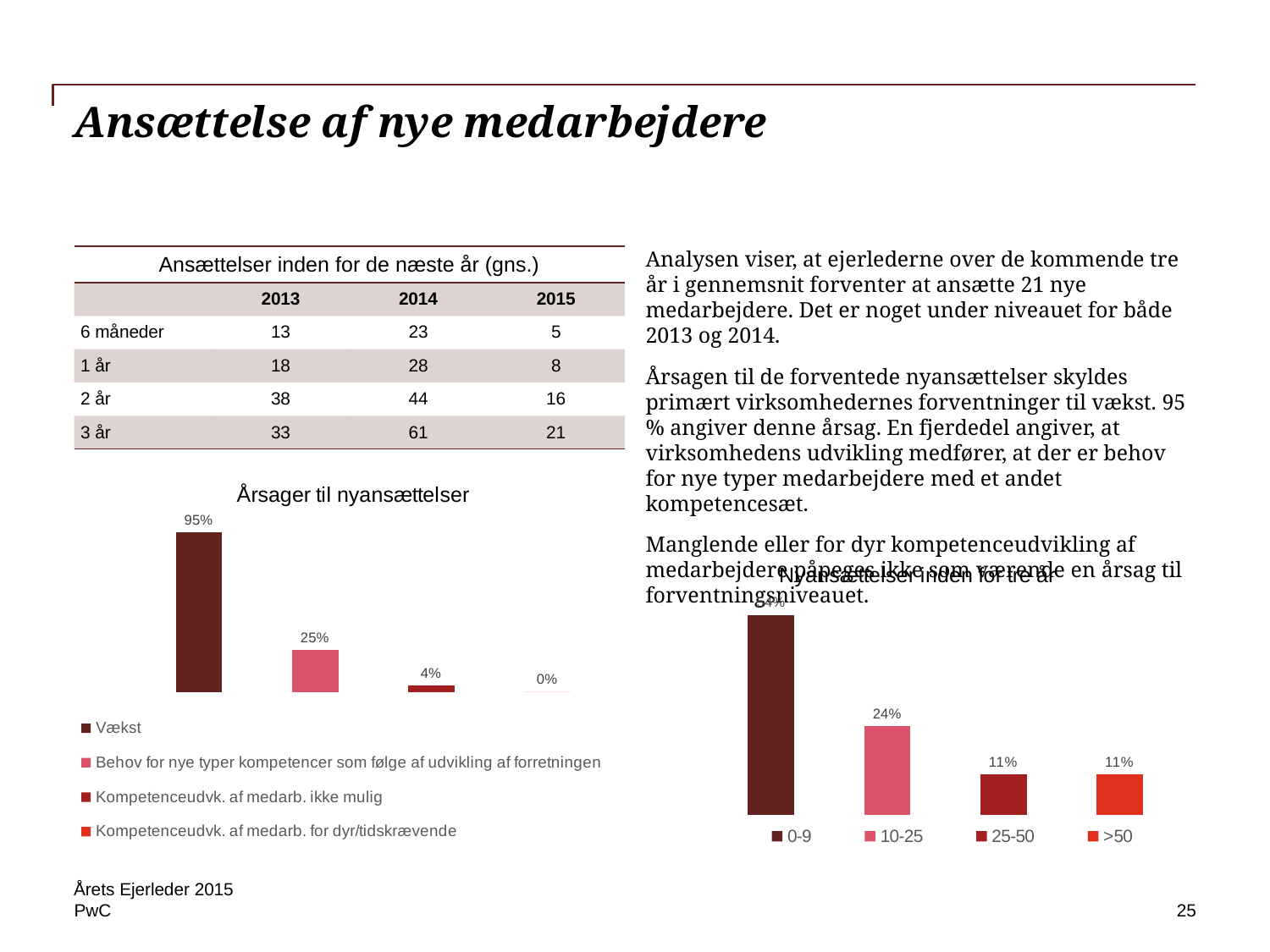
In the chart 'Årsager til nyansættelser', what is the difference between the values for Vækst and 'Behov for nye typer kompetencer som følge af udvikling af forretningen'? 70% How many entries does the legend of the chart 'Årsager til nyansættelser' list? 4 In the chart on the right, 'Nyansættelser inden for tre år', how many categories are shown? 4 In the chart on the right, 'Nyansættelser inden for tre år', what is the value for 25-50? 11% In the chart 'Årsager til nyansættelser', which category has the lowest value? Kompetenceudvk. af medarb. for dyr/tidskrævende In the chart 'Årsager til nyansættelser', what is the value for 'Kompetenceudvk. af medarb. ikke mulig'? 4% What kind of chart is the chart on the right of the slide, 'Nyansættelser inden for tre år'? Bar chart In the chart on the right, 'Nyansættelser inden for tre år', which category has the highest value? 0-9 In the chart on the right, 'Nyansættelser inden for tre år', what is the value for 10-25? 24% In the chart 'Årsager til nyansættelser', what is the value for 'Behov for nye typer kompetencer som følge af udvikling af forretningen'? 25% In the chart 'Årsager til nyansættelser', what is the value for Vækst? 95% In the chart 'Årsager til nyansættelser', which category has the highest value? Vækst